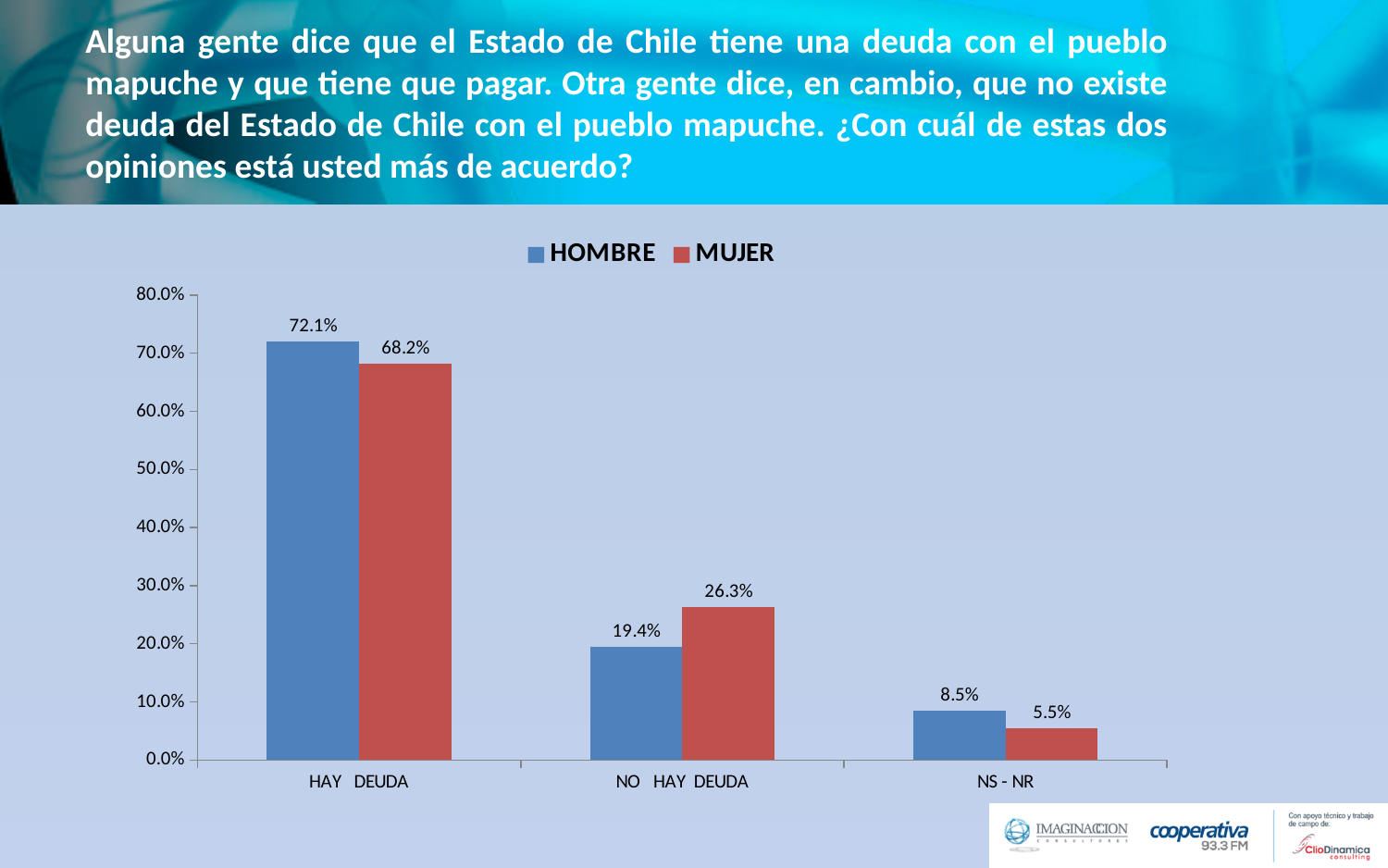
In the NO HAY DEUDA category, which series has the larger value, HOMBRE or MUJER? MUJER What kind of chart is shown on the slide? Bar chart How many categories are shown on the x axis? 3 What is the value for HOMBRE in the HAY DEUDA category? 72.1% In the NS - NR category, which series has the larger value, HOMBRE or MUJER? HOMBRE How many series does the legend list? 2 What is the value for MUJER in the NS - NR category? 5.5% Which category has the lowest value for MUJER? NS - NR Which category has the highest value for HOMBRE? HAY DEUDA What is the difference between the MUJER and HOMBRE values in the NO HAY DEUDA category? 6.9% What is the value for MUJER in the NO HAY DEUDA category? 26.3% What is the difference between the HOMBRE and MUJER values in the HAY DEUDA category? 3.9%